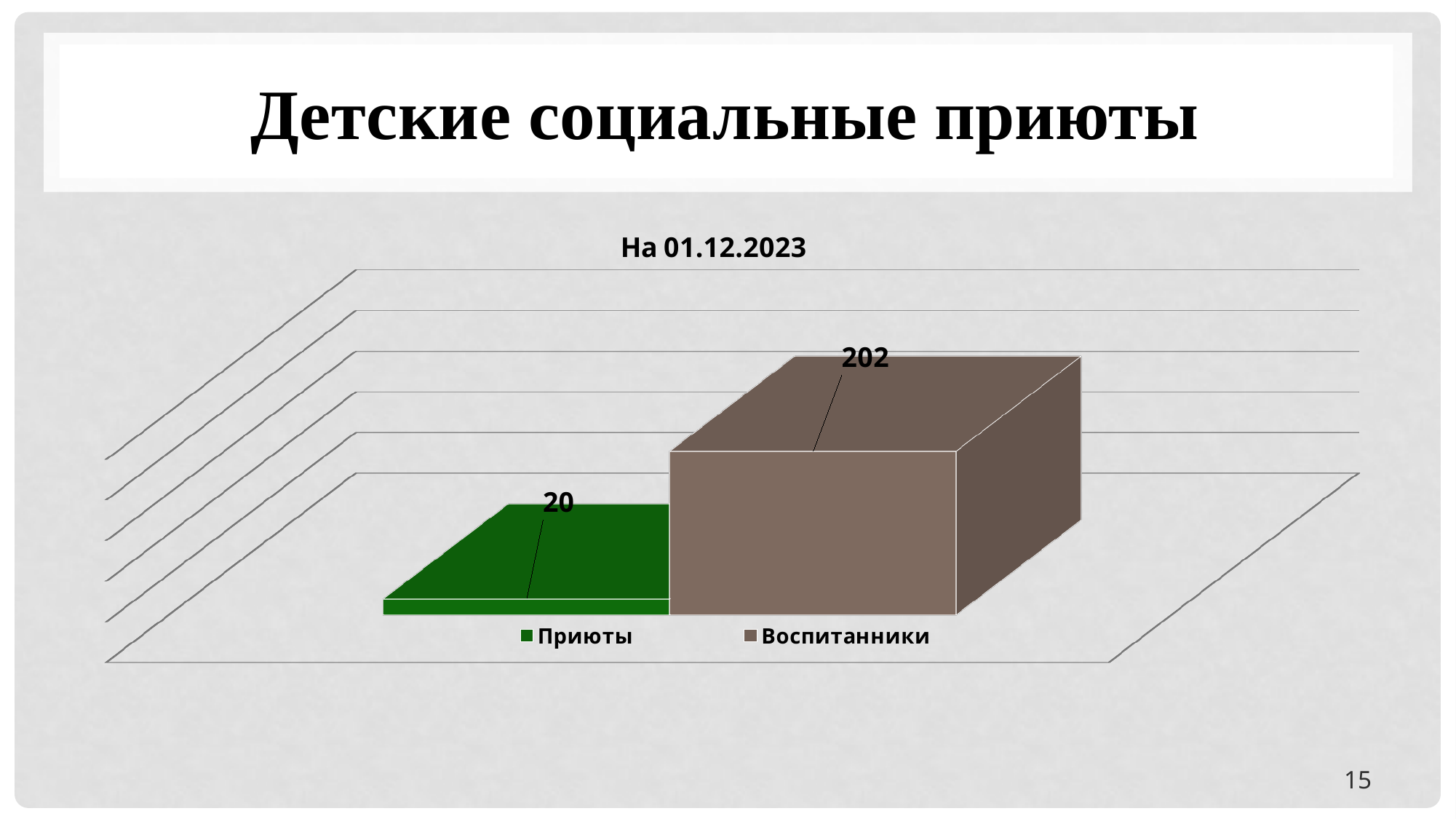
Which series has the highest value? Воспитанники How many bars are plotted on the chart? 2 How many series does the legend list? 2 What colour is the bar for Приюты? green What is the value for Приюты? 20 Which series has the lowest value? Приюты Which is larger, the value for Приюты or the value for Воспитанники? Воспитанники What kind of chart is shown on the slide? bar chart What is the value for Воспитанники? 202 What is the title of the chart? На 01.12.2023 What is the difference between the values for Воспитанники and Приюты? 182